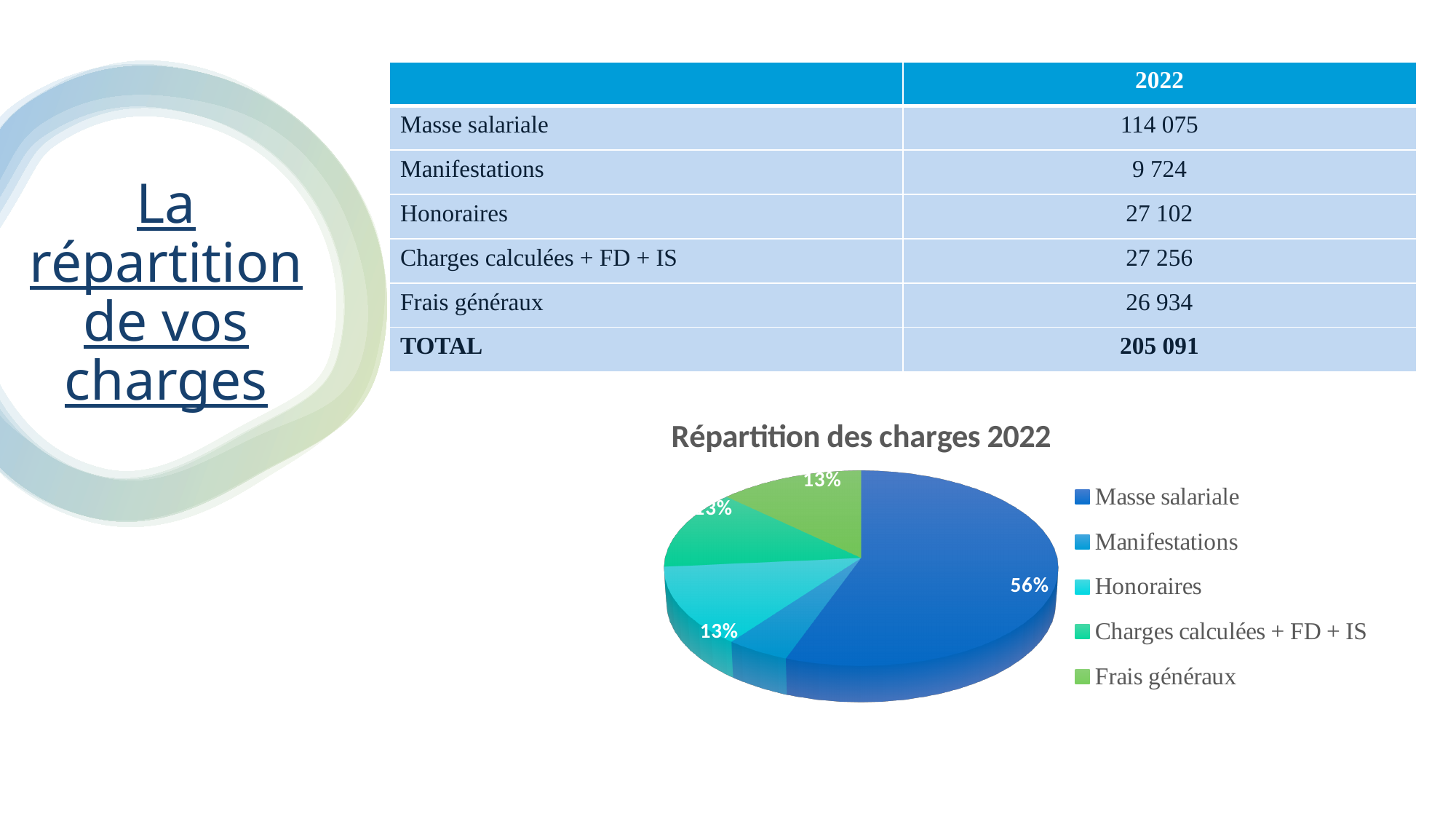
How many slices does the pie chart have? 5 What kind of chart is shown on the slide? pie chart What share of the pie does Masse salariale represent? 56% Which category has the smallest slice of the pie? Manifestations What share of the pie does Honoraires represent? 13% Which category has the largest slice of the pie? Masse salariale How many entries does the chart legend list? 5 Which slice is larger, Manifestations or Honoraires? Honoraires What is the title of the chart? Répartition des charges 2022 Which category is shown in green in the pie chart? Frais généraux Which slice is larger, Masse salariale or Honoraires? Masse salariale What share of the pie does Frais généraux represent? 13%